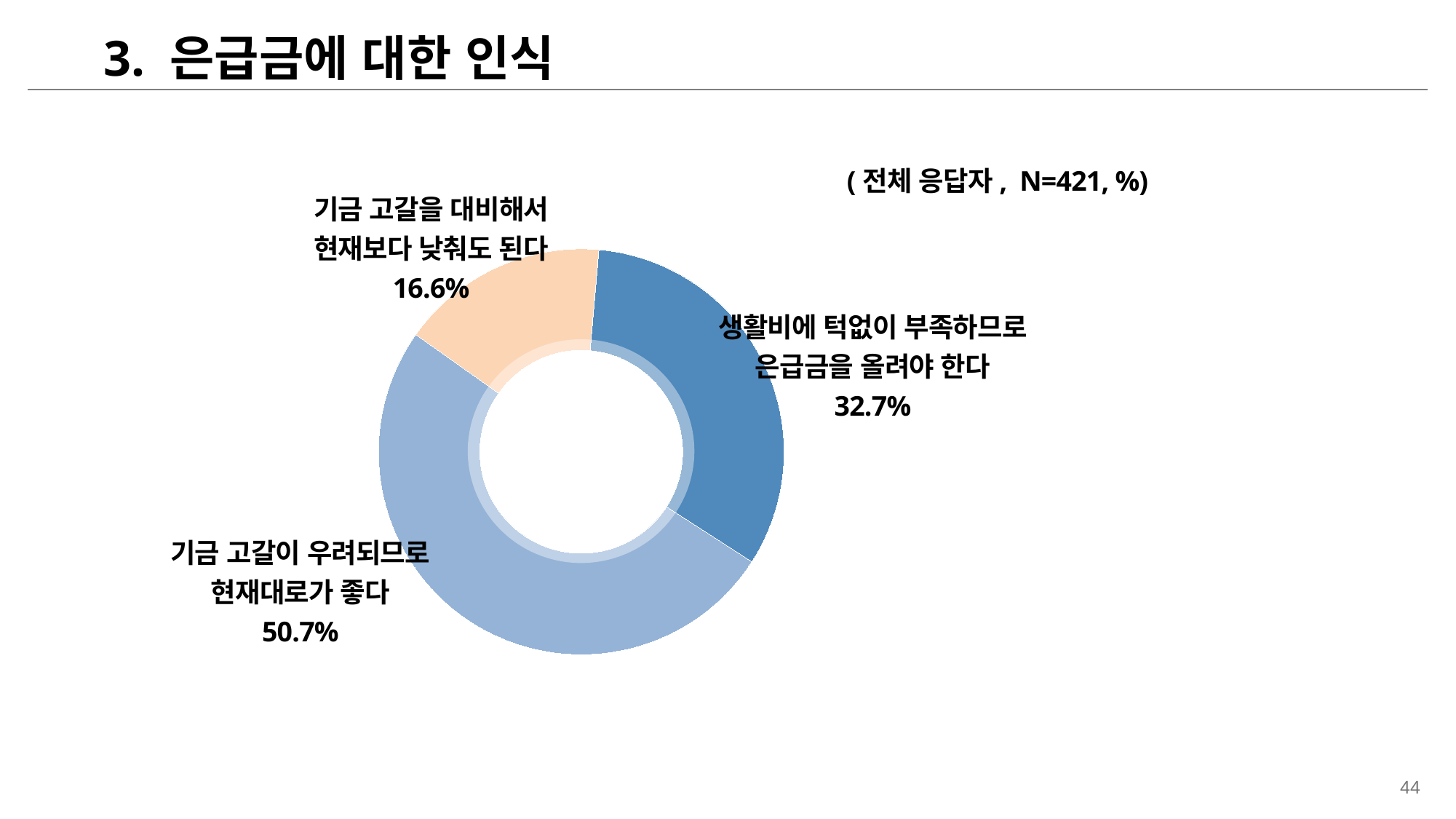
Which is larger: the share for '생활비에 턱없이 부족하므로 은급금을 올려야 한다' or for '기금 고갈을 대비해서 현재보다 낮춰도 된다'? 생활비에 턱없이 부족하므로 은급금을 올려야 한다 Which response has the largest share in the chart? 기금 고갈이 우려되므로 현재대로가 좋다 What share of respondents chose '생활비에 턱없이 부족하므로 은급금을 올려야 한다'? 32.7% What kind of chart is shown on the slide? Doughnut (pie) chart What is the title of the slide? 3. 은급금에 대한 인식 What is the difference in percentage points between '생활비에 턱없이 부족하므로 은급금을 올려야 한다' and '기금 고갈을 대비해서 현재보다 낮춰도 된다'? 16.1 percentage points What share of respondents chose '기금 고갈이 우려되므로 현재대로가 좋다'? 50.7% How many response categories are shown in the chart? 3 Which response has the smallest share in the chart? 기금 고갈을 대비해서 현재보다 낮춰도 된다 What share of respondents chose '기금 고갈을 대비해서 현재보다 낮춰도 된다'? 16.6% How many respondents (N) does the chart note indicate? 421 What is the difference in percentage points between '기금 고갈이 우려되므로 현재대로가 좋다' and '생활비에 턱없이 부족하므로 은급금을 올려야 한다'? 18.0 percentage points